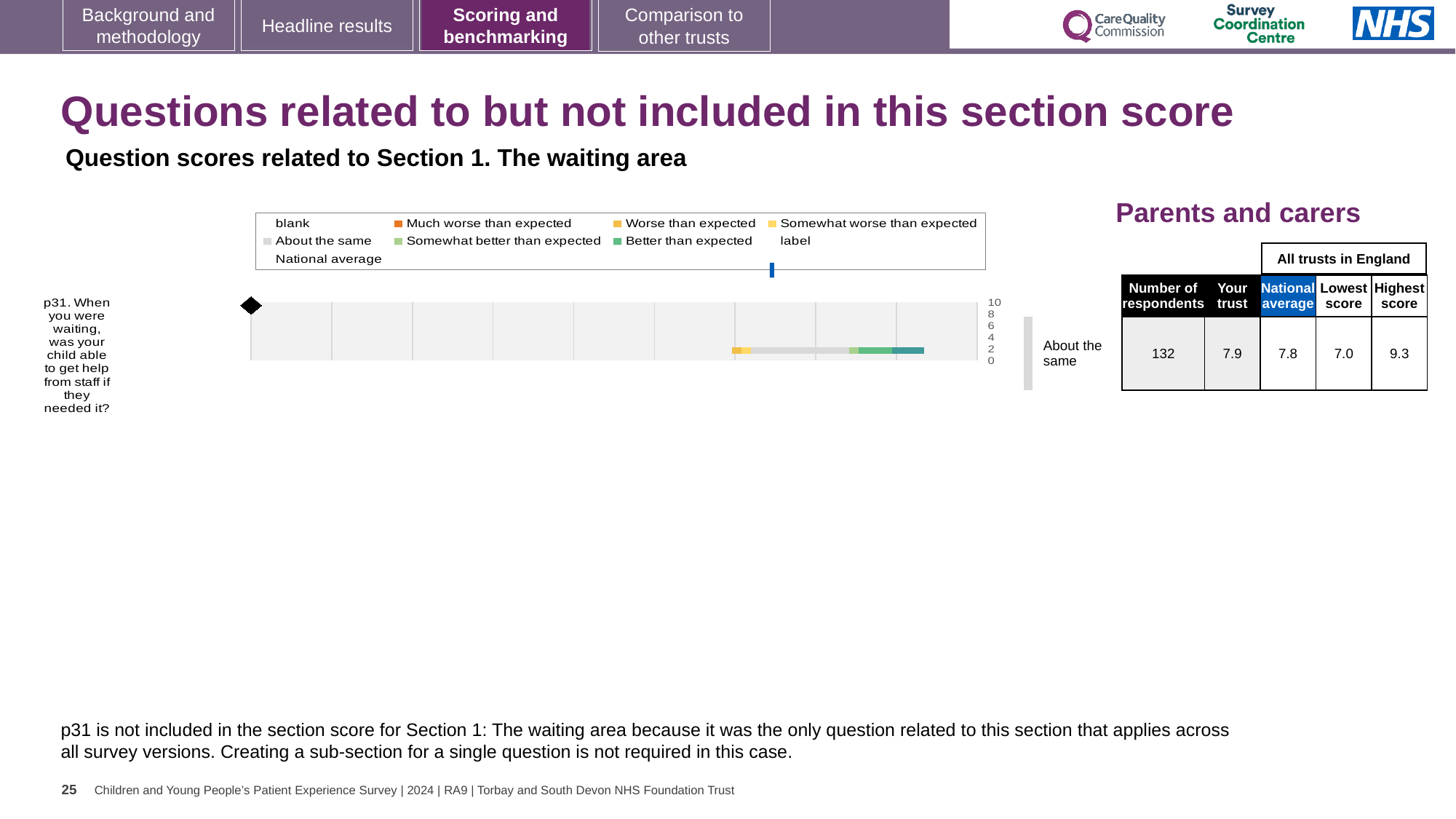
What colour does the legend use for 'Much worse than expected'? orange Which question number is plotted in the chart? p31 What kind of chart is used to show the p31 question score? bar chart In the table beside the chart, what is the 'Your trust' score for p31? 7.9 What benchmark rating is shown next to the bar for p31? About the same In the table beside the chart, what is the national average score for p31? 7.8 For p31, which is larger: the 'Your trust' score or the national average? Your trust In the table beside the chart, what is the lowest score among all trusts in England for p31? 7.0 How many respondents are listed for p31? 132 What is the difference between the highest score and the lowest score for p31? 2.3 In the table beside the chart, what is the highest score among all trusts in England for p31? 9.3 How many survey questions are plotted in the chart? 1